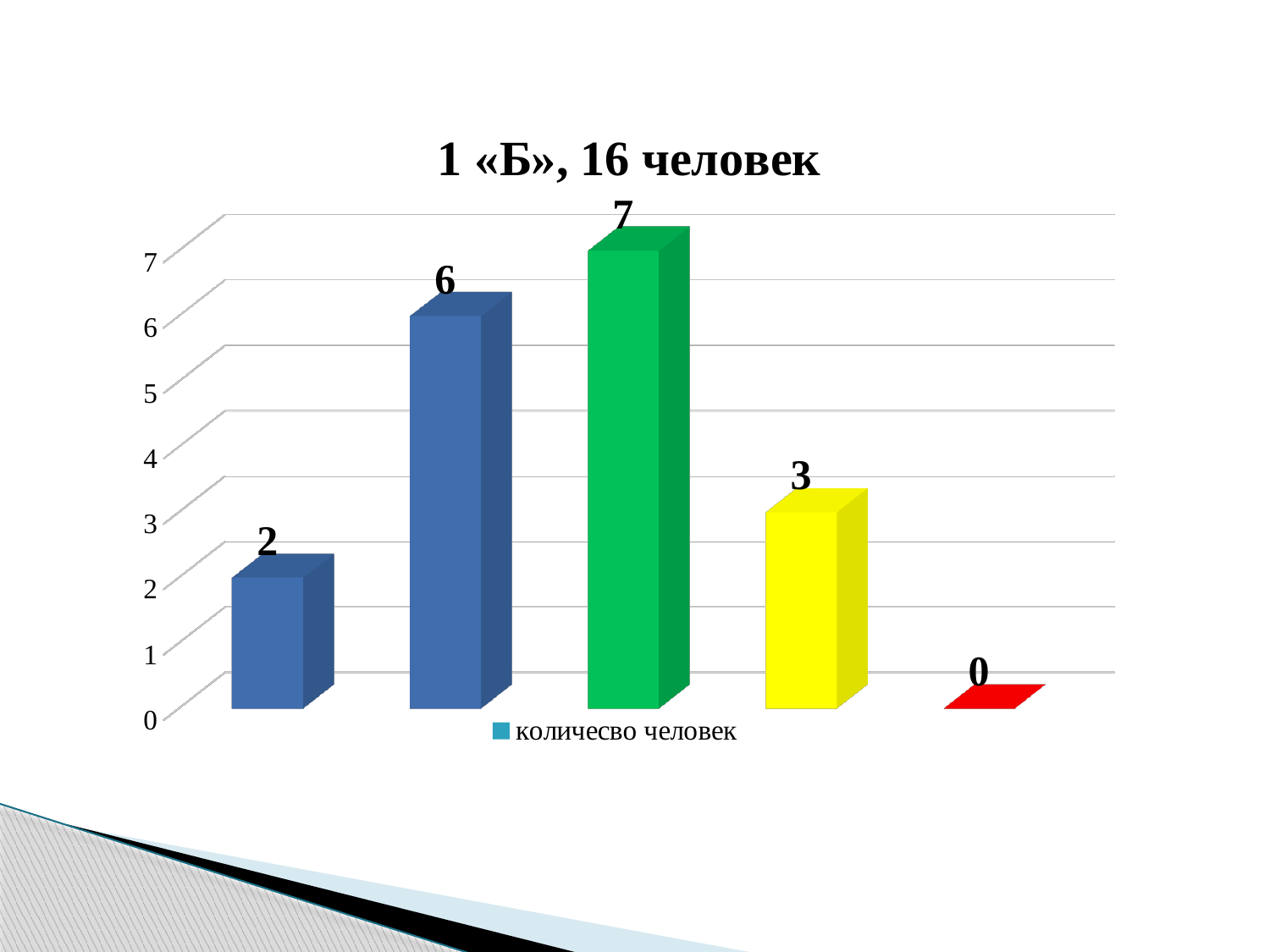
What kind of chart is shown on the slide? bar chart Which is larger: the value of the second bar or the value of the fourth bar? the second bar (6) Which bar has the highest value? the green bar (third bar), 7 What is the difference between the value of the green bar and the value of the yellow bar? 4 What is the value shown on the red bar at the far right? 0 What is the title of the chart? 1 «Б», 16 человек What is the value shown on the green bar? 7 What is the value shown on the first (leftmost) bar? 2 How many bars (categories) are plotted in the chart? 5 Which bar has the lowest value? the red bar (fifth bar), 0 What is the value shown on the yellow bar? 3 How many series does the legend list? 1